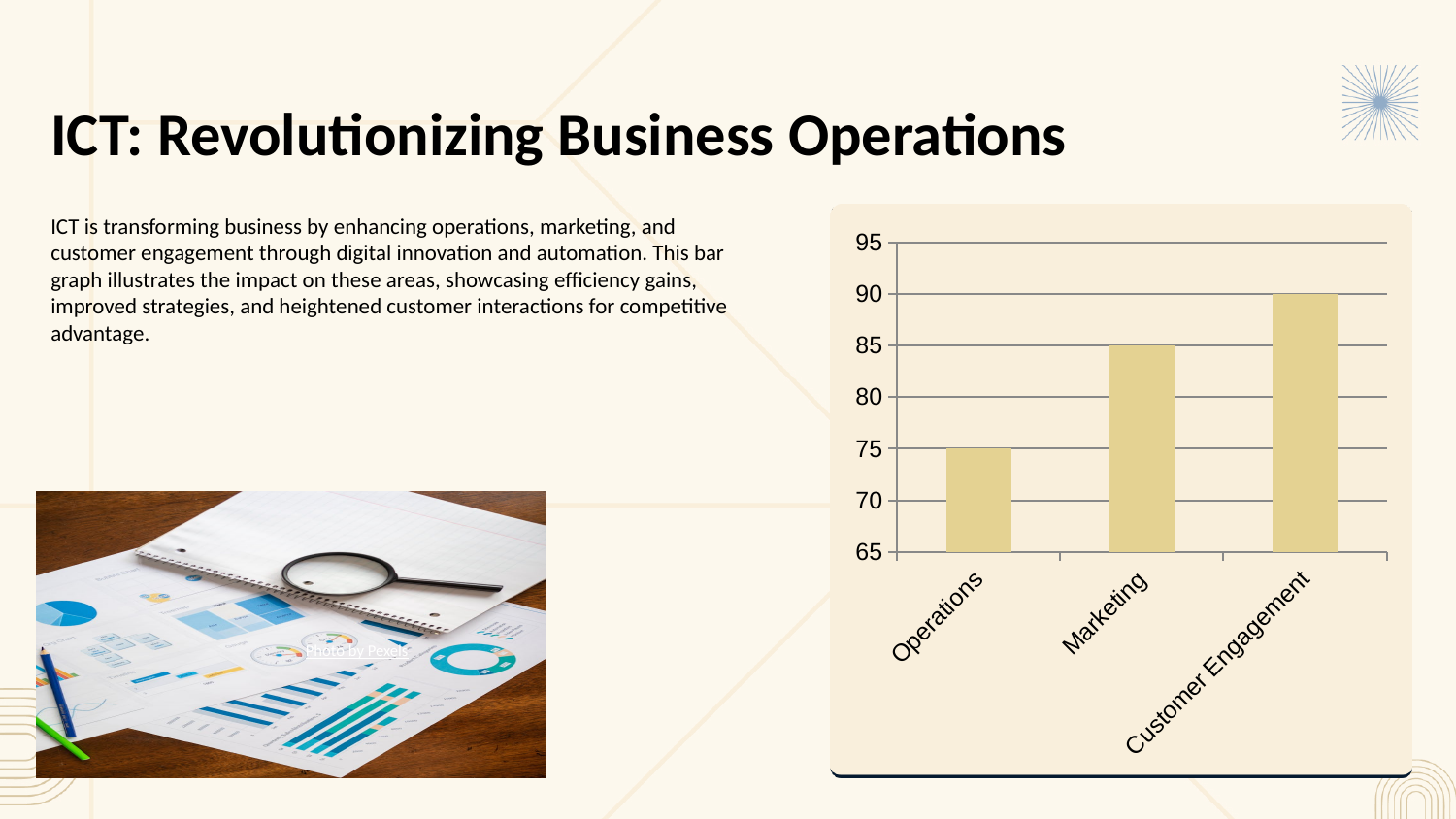
Which category has the highest value? Customer Engagement Is the value for Operations greater or less than 80? less What is the value for Customer Engagement? 90 Which category has the lowest value? Operations What kind of chart is shown on the slide? bar chart What is the value for Marketing? 85 Do the values rise or fall from left to right along the x axis? rise Which is larger, the value for Marketing or the value for Operations? Marketing What is the difference between the values for Customer Engagement and Operations? 15 What is the difference between the values for Marketing and Operations? 10 How many categories are plotted in the bar chart? 3 What is the value for Operations? 75